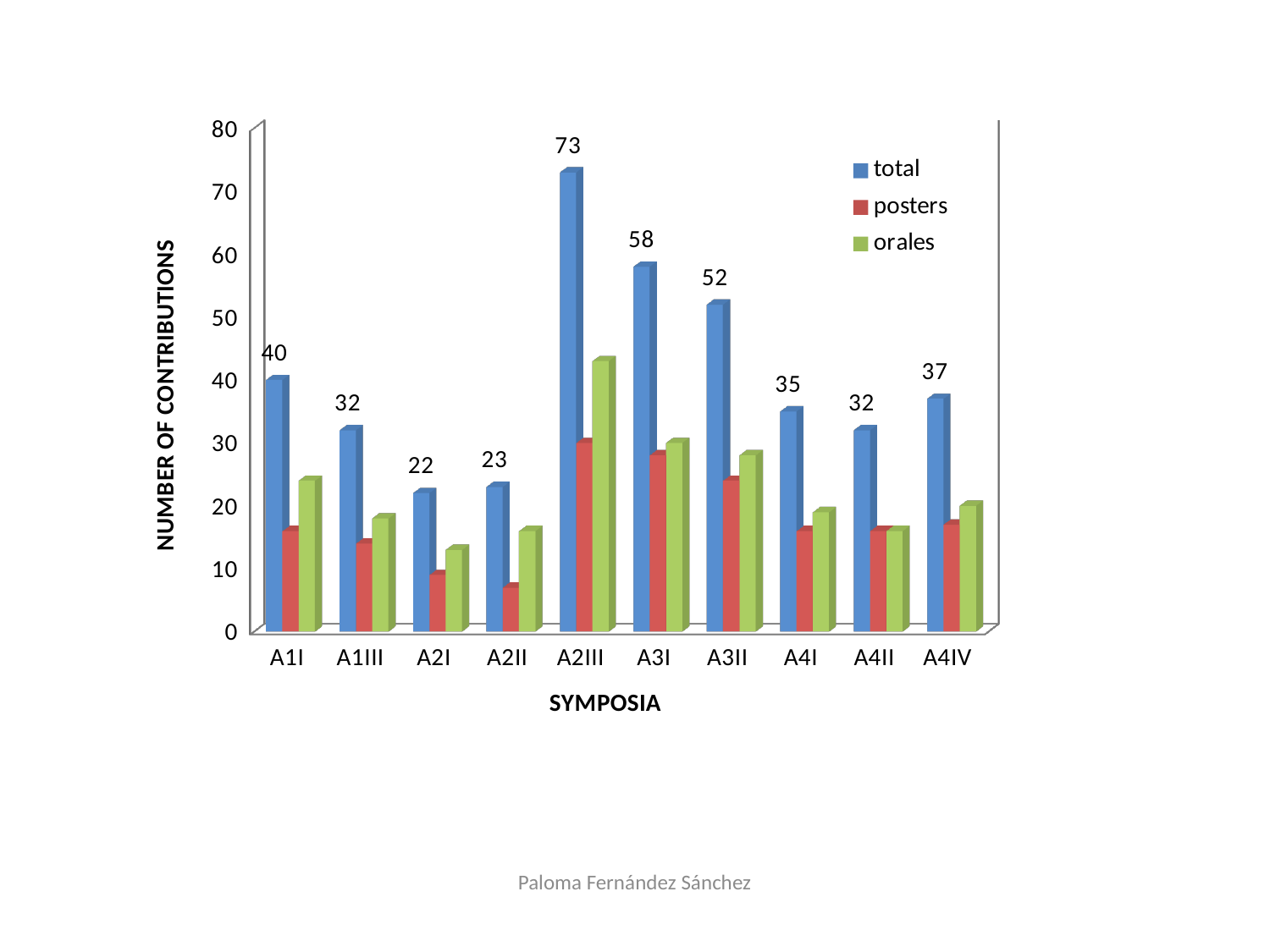
How many symposia are shown on the x axis? 10 What is the total number of contributions for symposium A3I? 58 What kind of chart is shown on the slide? bar chart What is the difference between the total contributions for A2III and A3I? 15 Is the orales value for A1I greater or less than 20? greater Is the posters value for A2II greater or less than 10? less What is the total number of contributions for symposium A2III? 73 Which symposium has the lowest total number of contributions? A2I How many series does the legend list? 3 What is the total number of contributions for symposium A4IV? 37 Which has a larger total number of contributions, A3II or A4I? A3II Which symposium has the highest total number of contributions? A2III